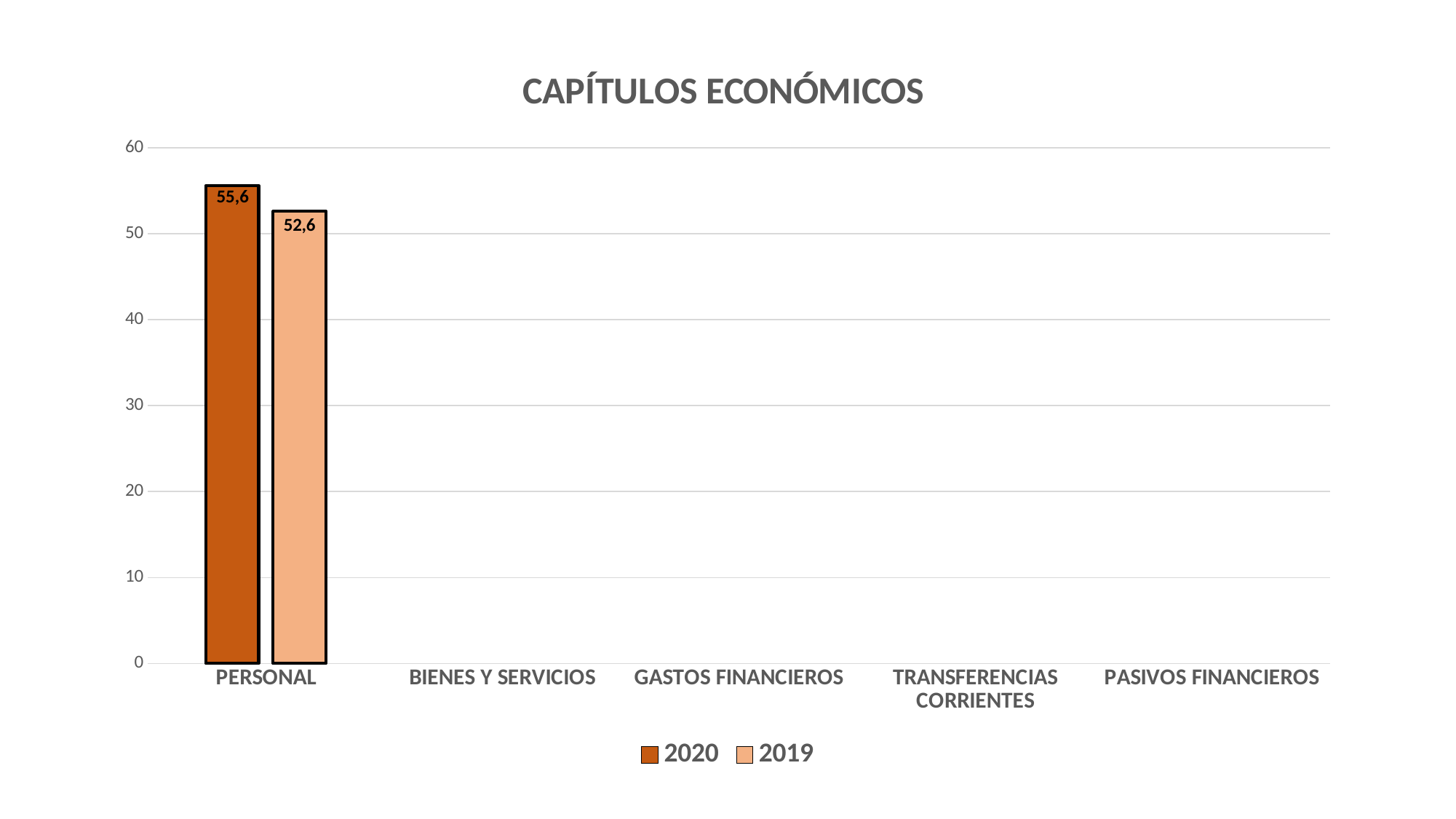
For PERSONAL, which series has the larger value, 2020 or 2019? 2020 Is the 2020 value for PERSONAL greater or less than 50? greater Is the 2019 value for PERSONAL greater or less than 60? less What kind of chart is shown on the slide? bar chart What is the value of the 2020 bar for PERSONAL? 55,6 How many series does the legend list? 2 What is the title of the chart? CAPÍTULOS ECONÓMICOS How many categories are listed on the x axis? 5 What is the value of the 2019 bar for PERSONAL? 52,6 What is the difference between the 2020 and 2019 values for PERSONAL? 3,0 Which series is shown in the darker orange colour? 2020